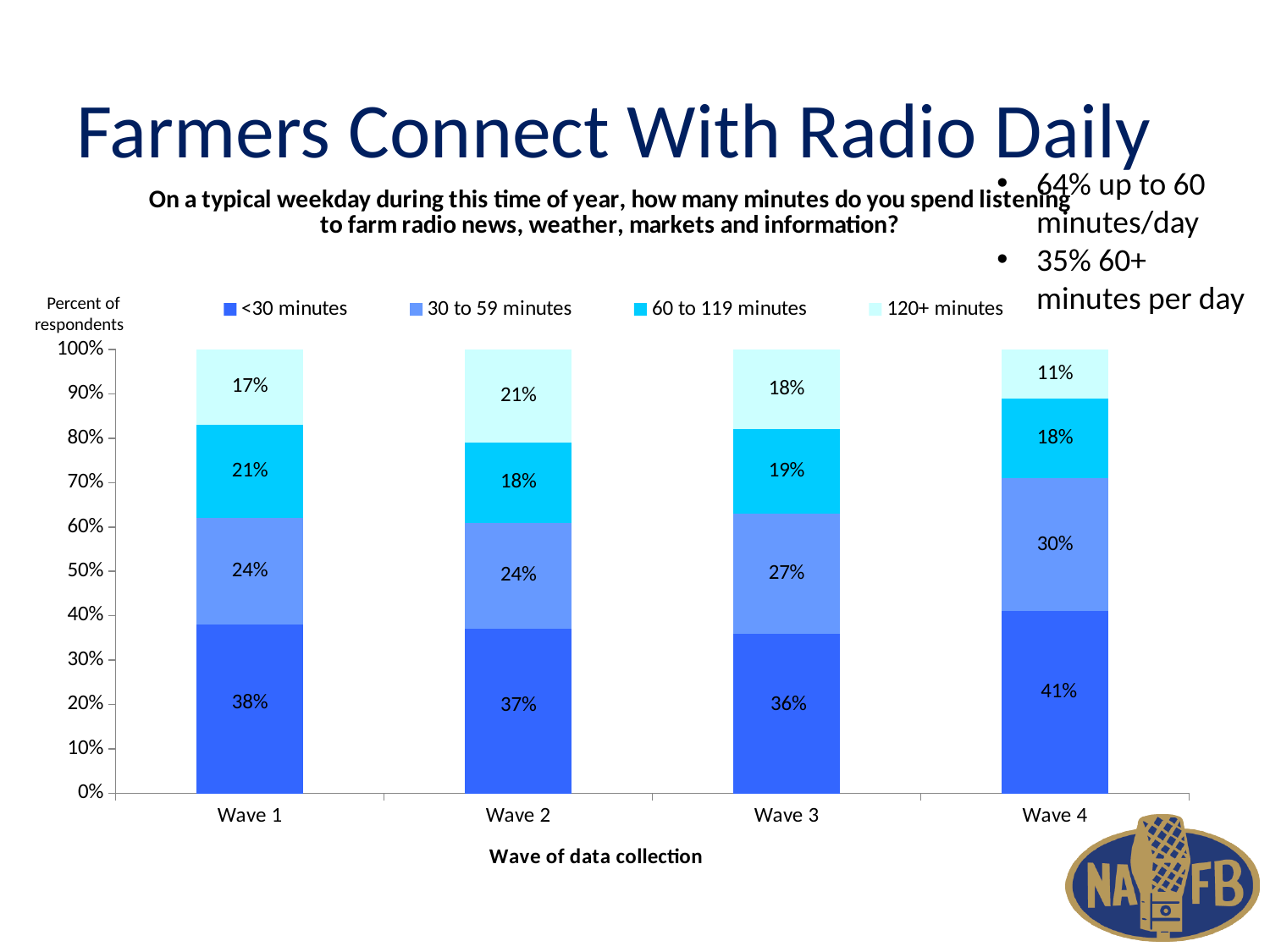
Which wave has the lowest value for 120+ minutes? Wave 4 How many waves of data collection are shown on the x axis? 4 Which wave has the highest value for <30 minutes? Wave 4 What is the total of the stacked bar for Wave 3? 100% What is the value for 30 to 59 minutes in Wave 3? 27% What percentage of respondents in Wave 4 listen for <30 minutes? 41% What is the value for 120+ minutes in Wave 2? 21% Which is larger, the 60 to 119 minutes value in Wave 1 or in Wave 2? Wave 1 What is the difference between the 30 to 59 minutes values for Wave 4 and Wave 1? 6% How many series does the legend list? 4 What kind of chart is shown on the slide? Stacked bar chart What is the label of the x axis? Wave of data collection